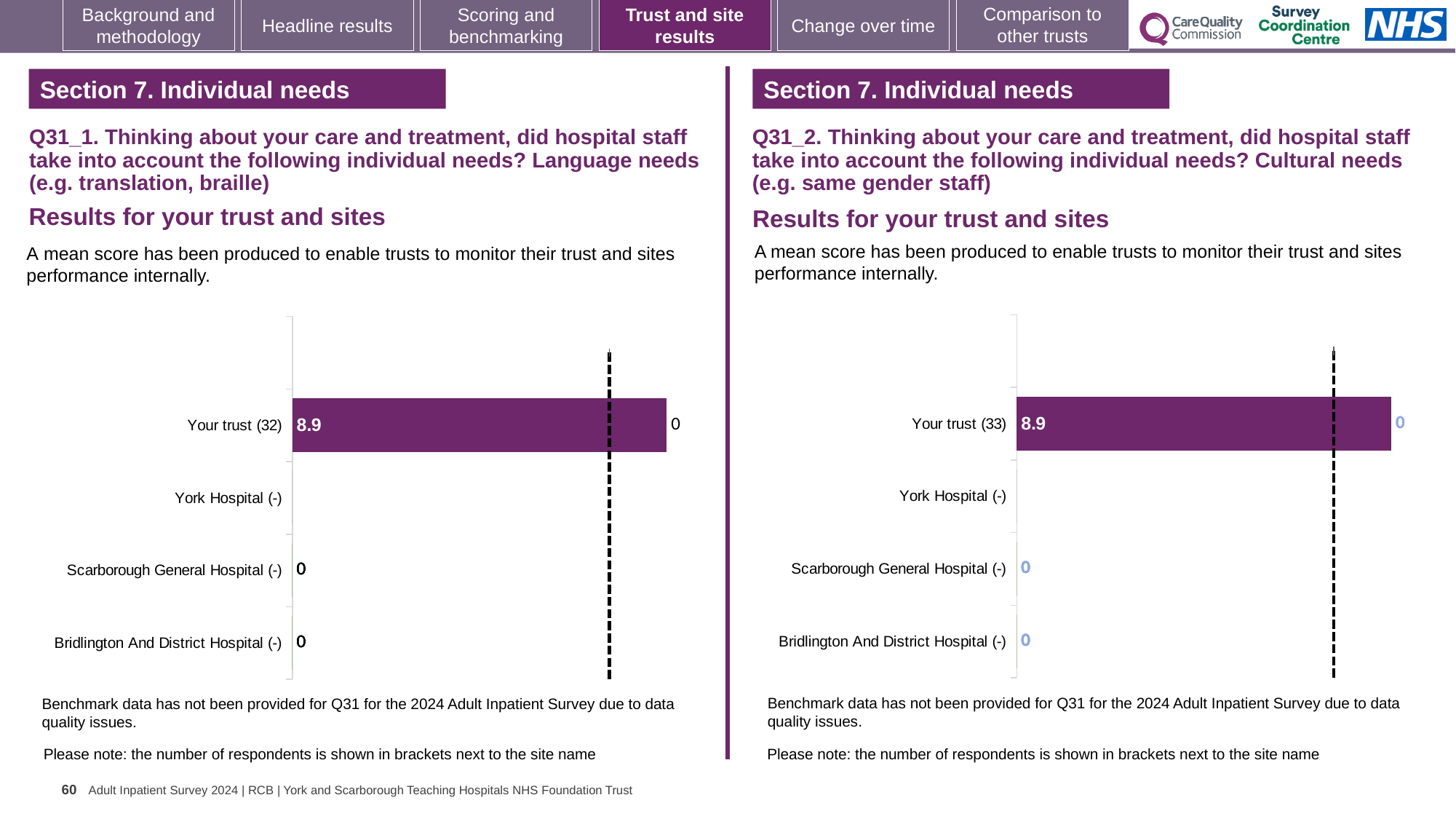
In the left chart (Q31_1, Language needs), which category has the highest mean score? Your trust (32) What kind of chart is used in the left chart (Q31_1, Language needs)? bar chart How many categories are listed on the vertical axis of the right chart (Q31_2, Cultural needs)? 4 In the right chart (Q31_2, Cultural needs), what is the mean score for Your trust? 8.9 How many categories are listed on the vertical axis of the left chart (Q31_1, Language needs)? 4 In the left chart (Q31_1, Language needs), how many respondents are shown in brackets next to Your trust? 32 In the left chart (Q31_1, Language needs), which is larger: the value for Your trust or the value for Scarborough General Hospital? Your trust In the right chart (Q31_2, Cultural needs), how many respondents are shown in brackets next to Your trust? 33 In the left chart (Q31_1, Language needs), what is the difference between the value for Your trust and the value for Bridlington And District Hospital? 8.9 In the right chart (Q31_2, Cultural needs), which is larger: the value for Your trust or the value for Bridlington And District Hospital? Your trust In the left chart (Q31_1, Language needs), what is the mean score for Your trust? 8.9 In the right chart (Q31_2, Cultural needs), which category has the highest mean score? Your trust (33)